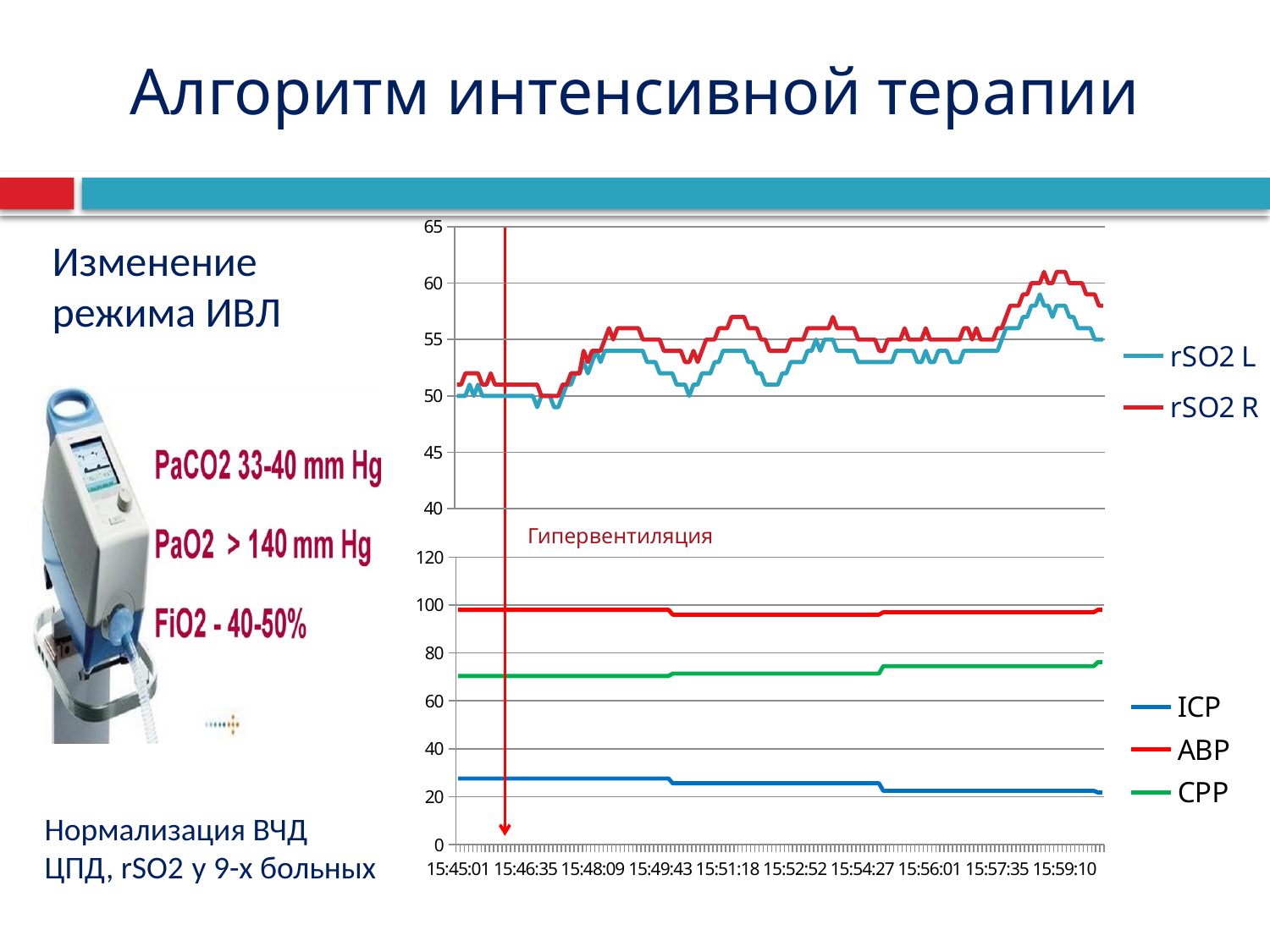
What event is labelled by the red vertical arrow on the charts? Гипервентиляция In the bottom chart, does the ICP line rise or fall over time? fall What kind of chart is the top chart on the slide (the one with rSO2 L and rSO2 R)? line chart How many series does the legend of the top chart list? 2 In the bottom chart, does the CPP line rise or fall over time? rise In the bottom chart, is the ABP value greater or less than 80? greater In the bottom chart, which series has the lowest values throughout? ICP What kind of chart is the bottom chart on the slide (the one with ICP, ABP and CPP)? line chart In the bottom chart, which series has the highest values throughout? ABP In the bottom chart, is the ICP value greater or less than 40? less In the top chart, do the rSO2 L and rSO2 R values generally rise or fall from left to right? rise How many series does the legend of the bottom chart list? 3